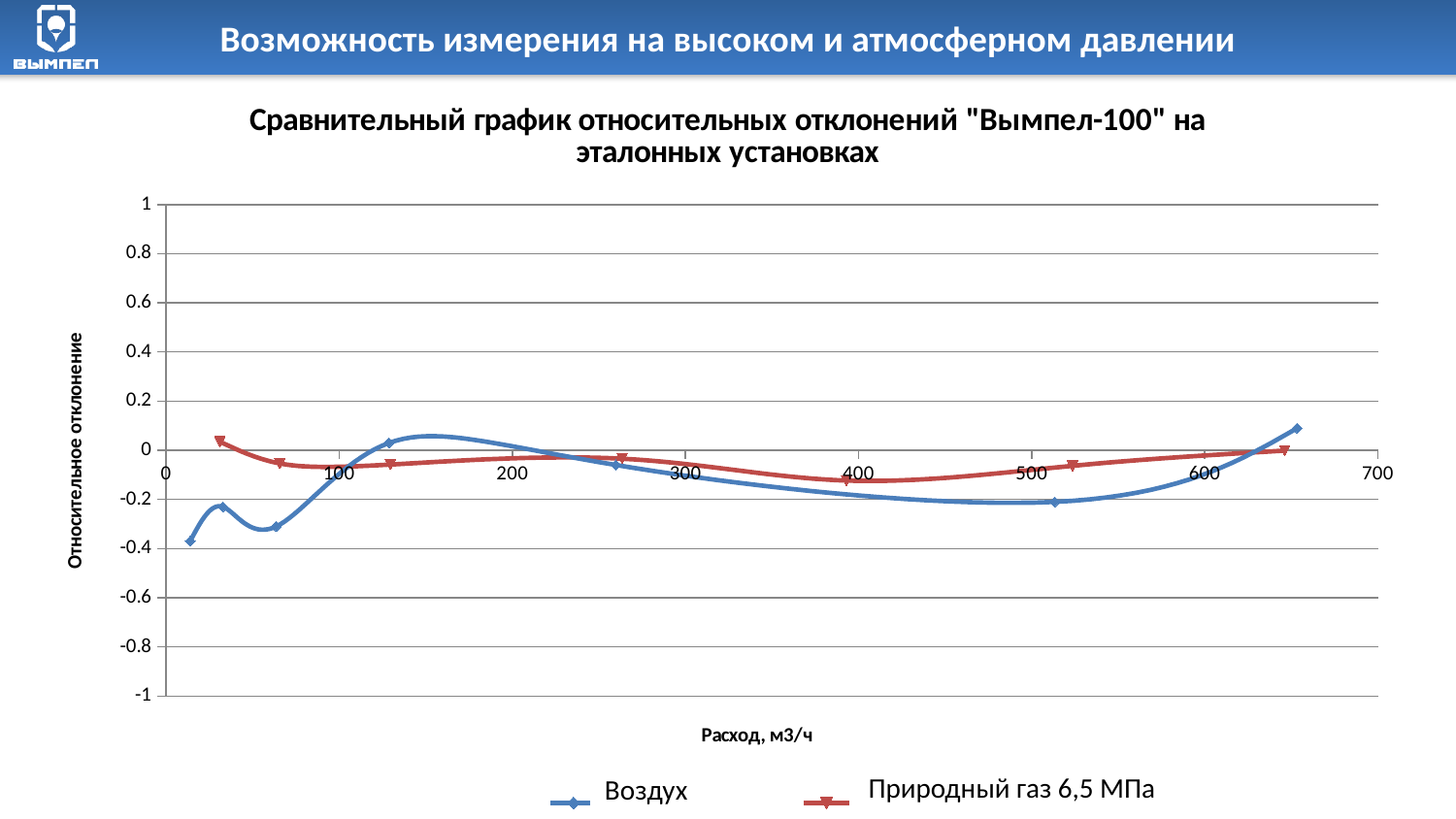
Is the lowest value of the Природный газ 6,5 МПа series greater or less than -0.2? greater Which series reaches the lowest relative deviation on the chart? Воздух Between about 500 and 650 on the x axis, does the Воздух series rise or fall? rise Is the value of the Воздух series at its last point (near 650 on the x axis) greater or less than 0? greater What kind of chart is shown on the slide? line chart How many series does the legend list? 2 What are the two series named in the legend? Воздух and Природный газ 6,5 МПа Near the start of the x axis (around 15 on the x axis), which series has the larger value: Воздух or Природный газ 6,5 МПа? Природный газ 6,5 МПа Is the highest value of the Природный газ 6,5 МПа series greater or less than 0.2? less What is the title of the chart? Сравнительный график относительных отклонений "Вымпел-100" на эталонных установках Which series reaches the highest relative deviation on the chart? Воздух